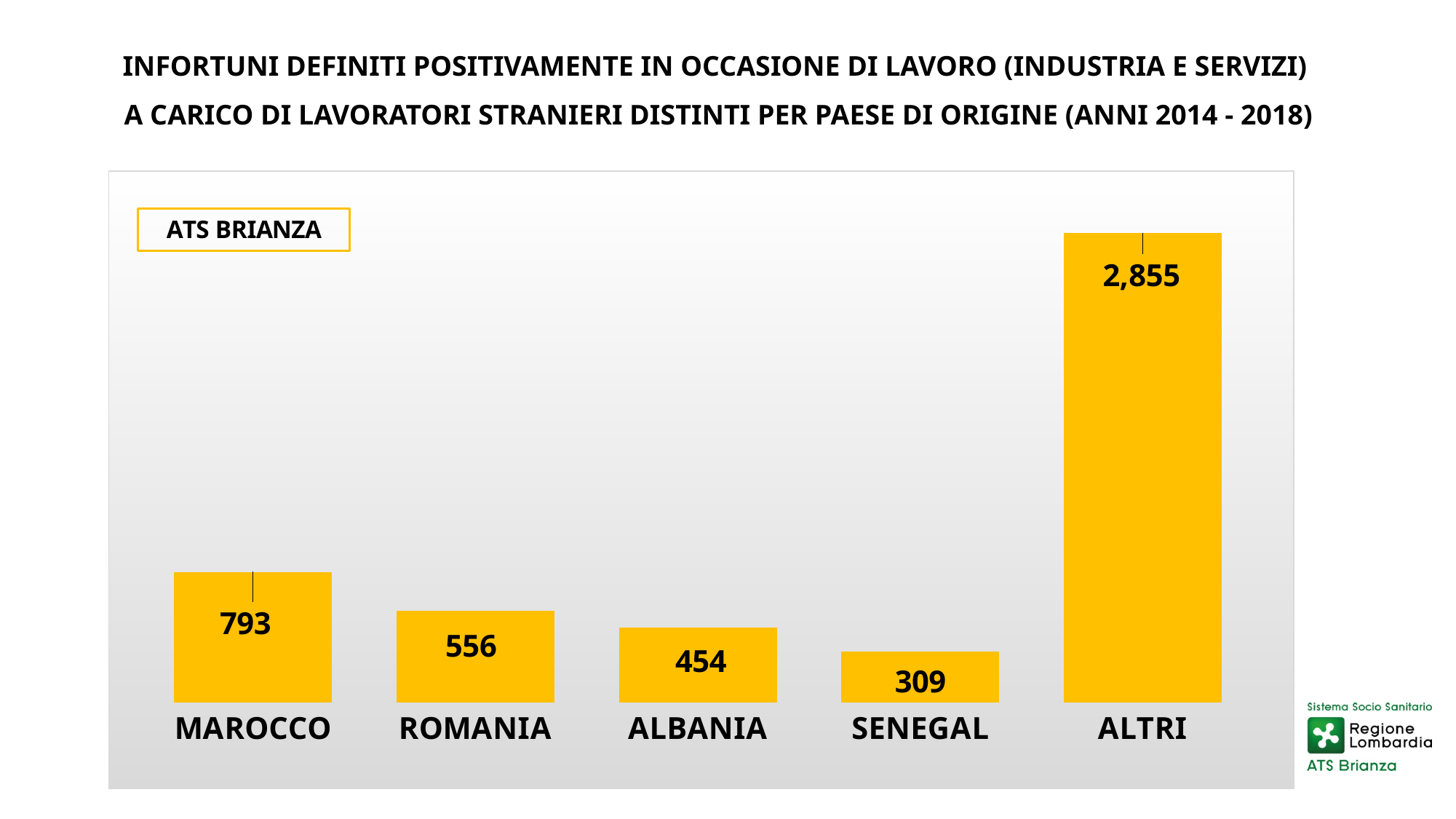
What is the value for ROMANIA? 556 What label appears in the box at the top left of the chart area? ATS BRIANZA Which category has the highest value? ALTRI What is the value for ALBANIA? 454 What is the value for ALTRI? 2,855 Which category has the lowest value? SENEGAL What is the difference between the values for MAROCCO and ROMANIA? 237 What kind of chart is shown on the slide? Bar chart What is the value for MAROCCO? 793 Which is larger, the value for ALBANIA or the value for SENEGAL? ALBANIA How many categories are shown in the chart? 5 What is the value for SENEGAL? 309